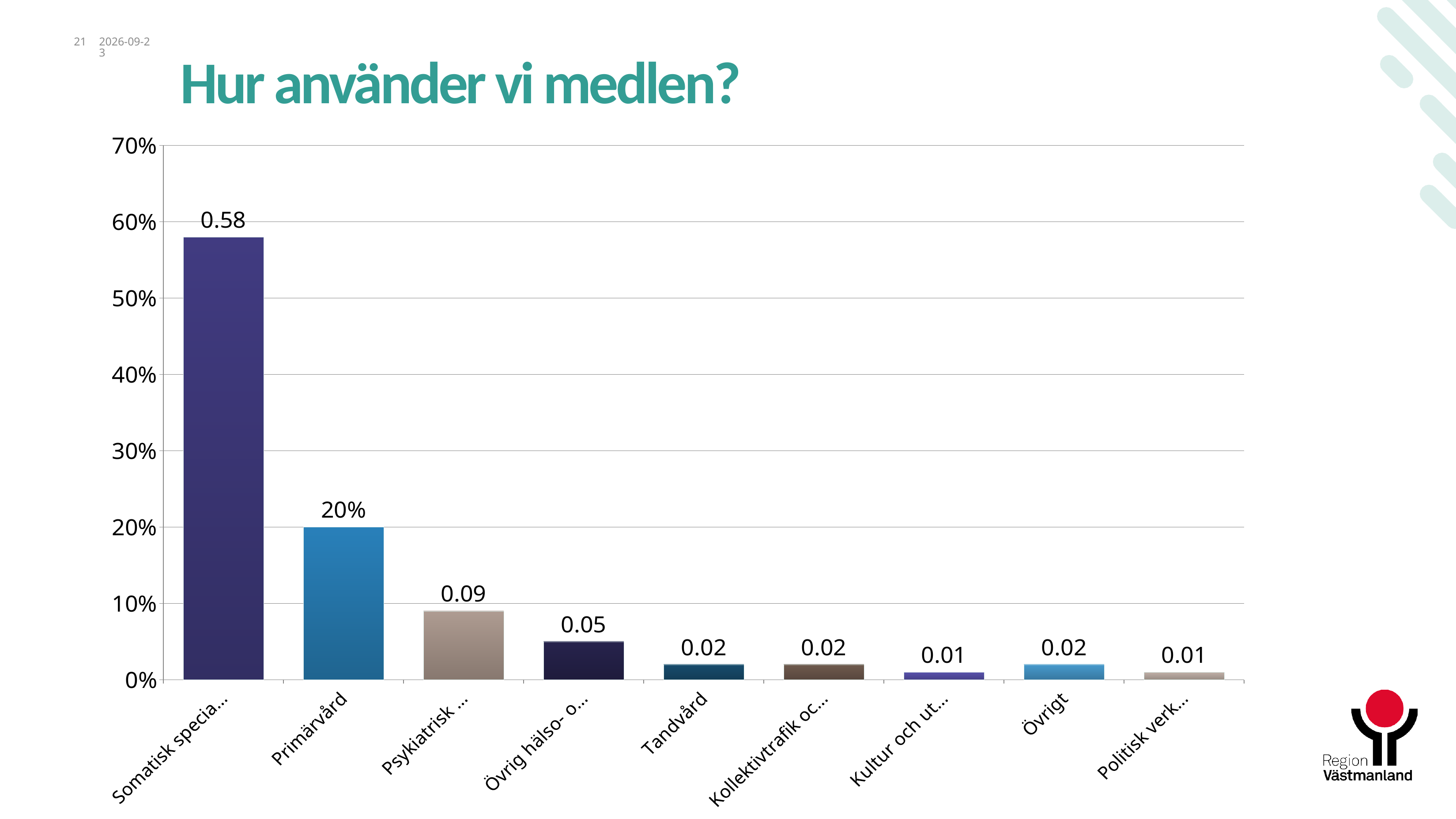
What is the value shown for Övrigt? 0.02 Is the value for Övrigt greater or less than 10%? less What is the data label on the first (tallest) bar of the chart? 0.58 What is the title of the chart on the slide? Hur använder vi medlen? Which category has the highest value in the chart? Somatisk specia... What type of chart is shown on the slide? bar chart Is the value for Primärvård greater or less than 10%? greater Do the bar values generally rise or fall from left to right along the x axis? fall What is the value shown for Tandvård? 0.02 What is the value shown for Primärvård? 20% Which is larger, the value for Primärvård or the value for Tandvård? Primärvård How many categories (bars) does the chart show? 9